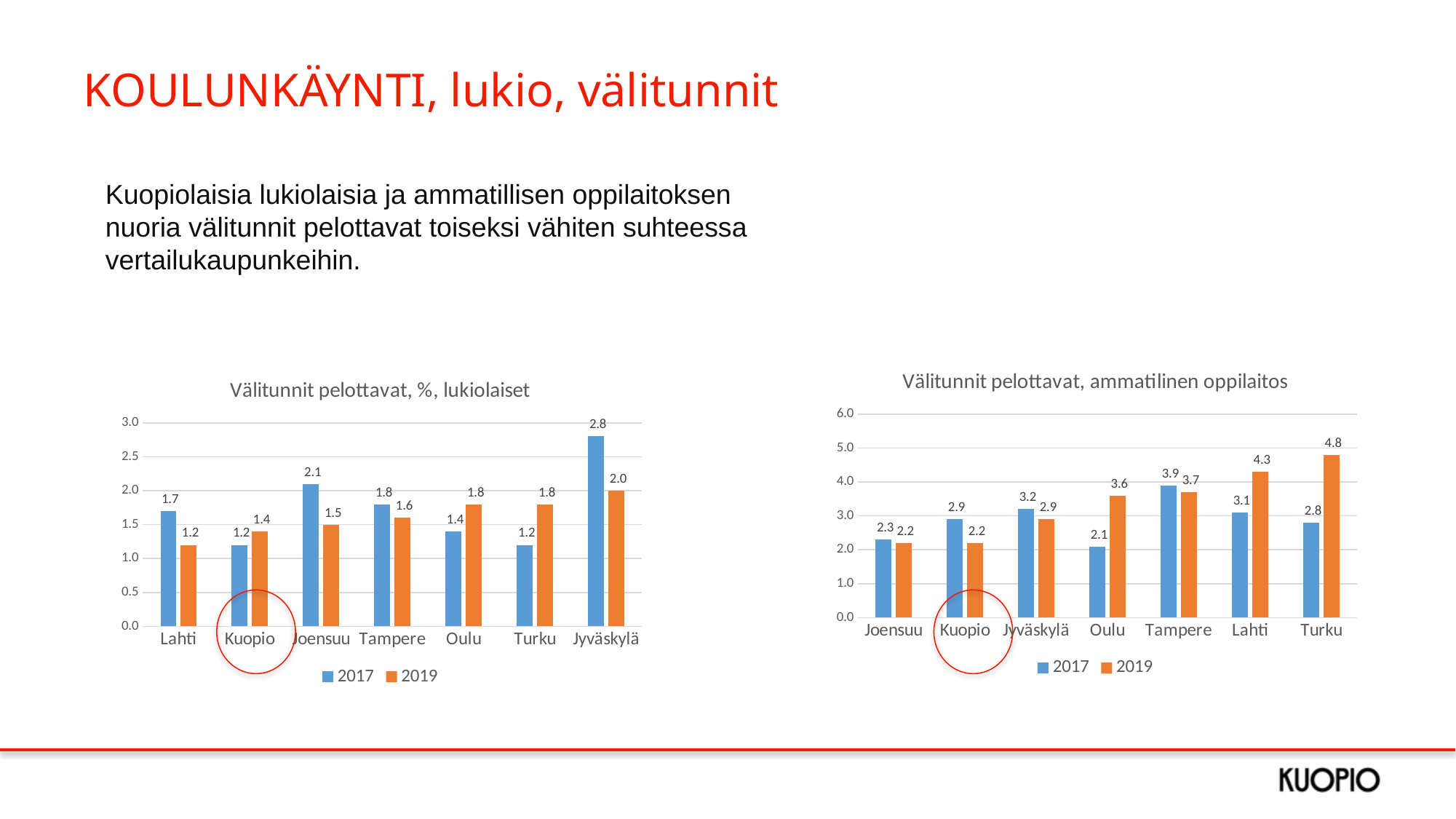
In the chart 'Välitunnit pelottavat, ammatilinen oppilaitos', which city has the lowest 2017 value? Oulu In the chart 'Välitunnit pelottavat, %, lukiolaiset', what is the difference between the 2017 and 2019 values for Joensuu? 0.6 In the chart 'Välitunnit pelottavat, ammatilinen oppilaitos', what is the difference between the 2019 and 2017 values for Oulu? 1.5 In the chart 'Välitunnit pelottavat, %, lukiolaiset', what is the 2019 value for Kuopio? 1.4 In the chart 'Välitunnit pelottavat, %, lukiolaiset', which city has the lowest 2019 value? Lahti In the chart 'Välitunnit pelottavat, %, lukiolaiset', how many cities are shown on the x axis? 7 In the chart 'Välitunnit pelottavat, %, lukiolaiset', which city has the highest 2017 value? Jyväskylä In the chart 'Välitunnit pelottavat, ammatilinen oppilaitos', which city has the highest 2017 value? Tampere In the chart 'Välitunnit pelottavat, ammatilinen oppilaitos', what is the 2019 value for Turku? 4.8 In the chart 'Välitunnit pelottavat, ammatilinen oppilaitos', is the 2019 value for Lahti larger or the 2017 value for Lahti? 2019 How many series does the legend list in the chart 'Välitunnit pelottavat, ammatilinen oppilaitos'? 2 In the chart 'Välitunnit pelottavat, %, lukiolaiset', what is the 2017 value for Jyväskylä? 2.8